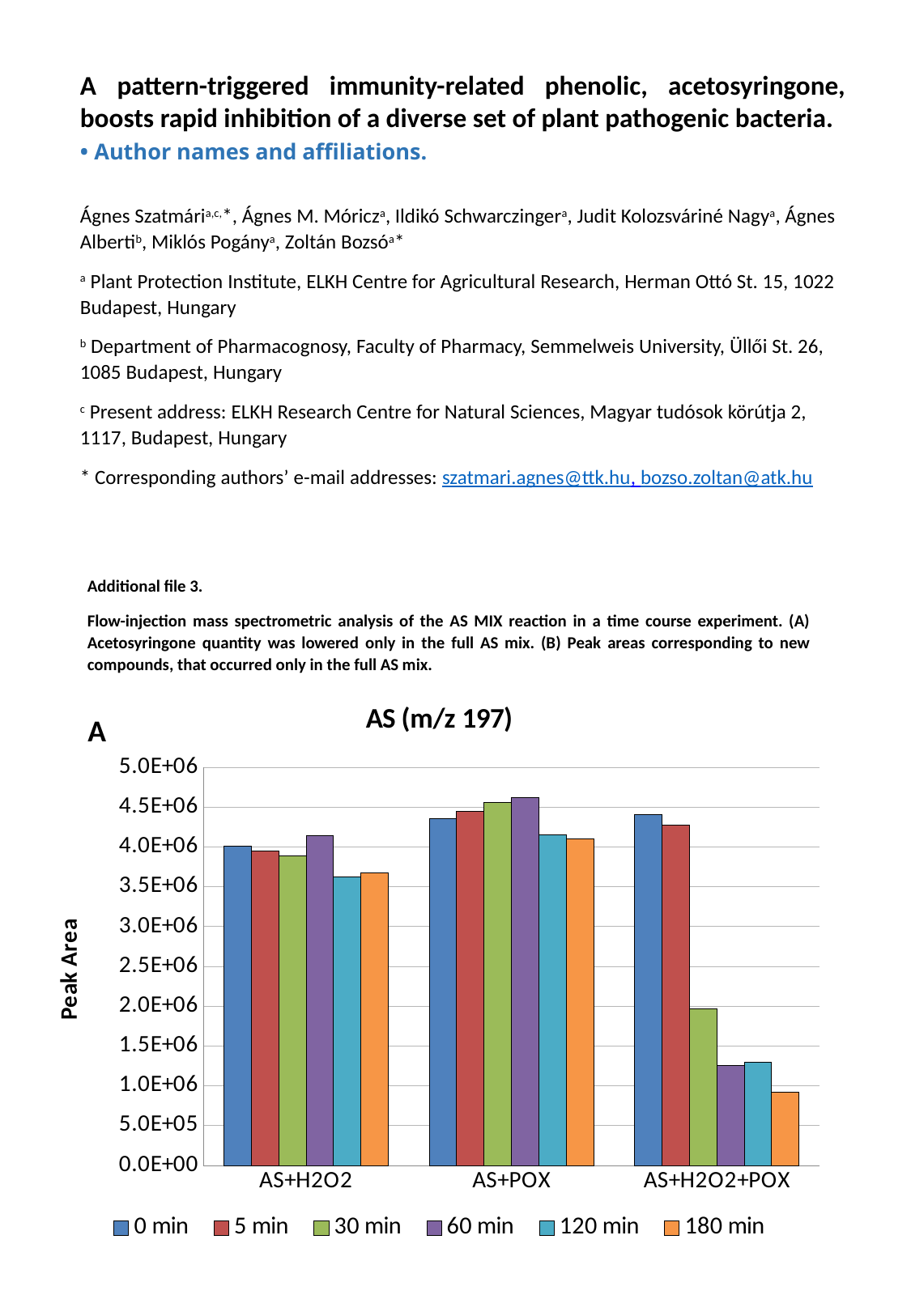
In the AS+H2O2+POX category, which is larger: the value for 0 min or the value for 180 min? 0 min How many series does the chart's legend list? 6 What is the label of the y axis? Peak Area Which time point has the lowest value in the AS+H2O2+POX category? 180 min In the AS+H2O2+POX category, do the values rise or fall from 0 min to 180 min? fall Is the value for 60 min in the AS+H2O2+POX category greater or less than 1.5E+06? less What is the title of the chart? AS (m/z 197) Is the value for 180 min in the AS+H2O2+POX category greater or less than 1.0E+06? less How many categories are shown on the x axis of the chart? 3 Is the value for 0 min in the AS+H2O2+POX category greater or less than 4.0E+06? greater What kind of chart is shown on the slide? bar chart